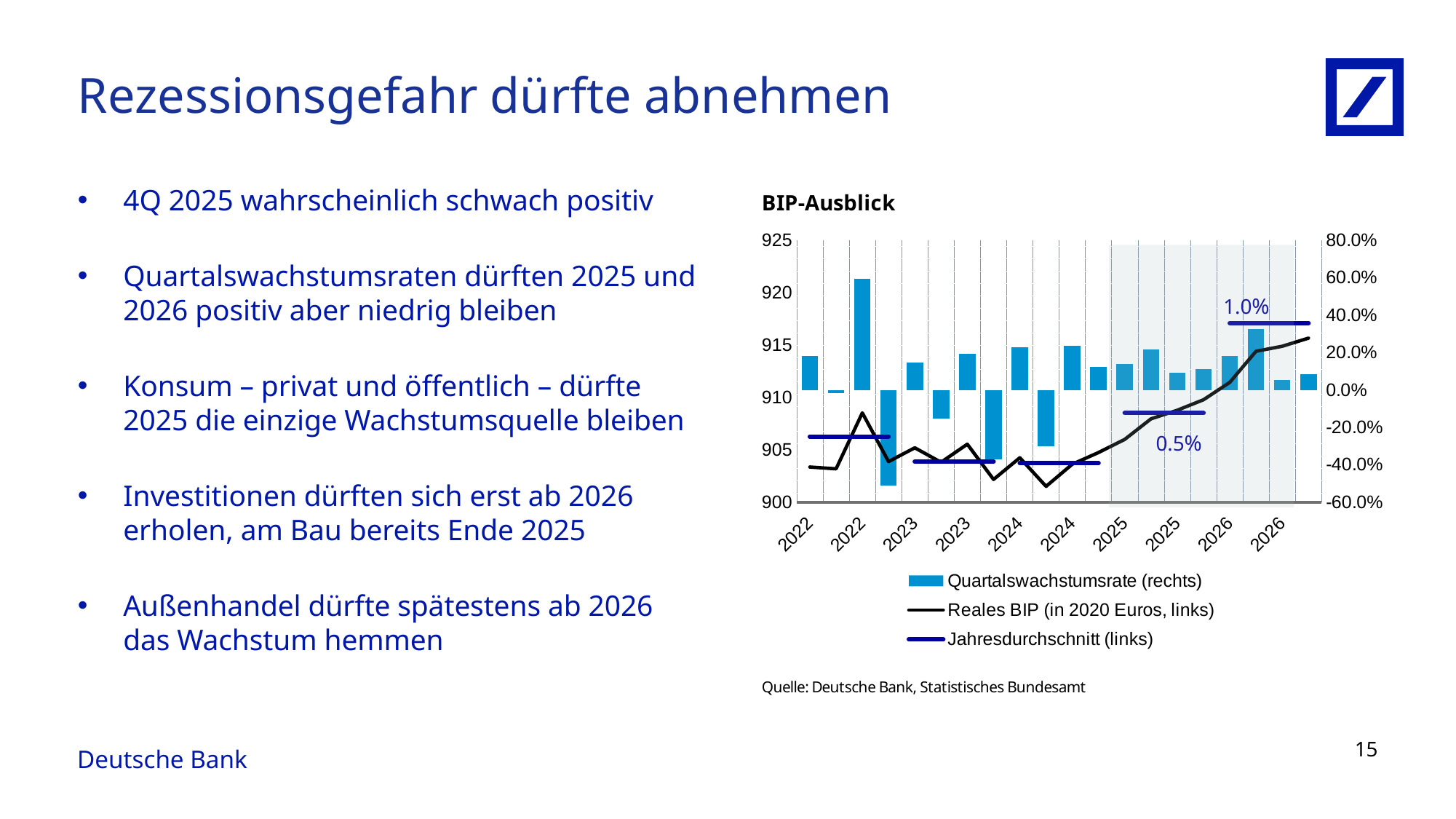
What is the labelled Jahresdurchschnitt value for 2026? 1.0% How many series does the chart legend list? 3 What kind of chart is shown on the slide? Combined bar and line chart What is the title of the chart on the slide? BIP-Ausblick What is the highest value shown on the right-hand axis? 80.0% What is the labelled Jahresdurchschnitt value for 2025? 0.5% Which labelled Jahresdurchschnitt value is larger, 2025 or 2026? 2026 What is the difference between the labelled Jahresdurchschnitt values for 2026 and 2025? 0.5 percentage points Is the tallest Quartalswachstumsrate bar greater or less than 40.0% on the right axis? greater Does the Reales BIP line rise or fall across the shaded 2025–2026 forecast area? rises In which year does the tallest Quartalswachstumsrate bar occur? 2022 How many year labels are shown on the x axis? 10